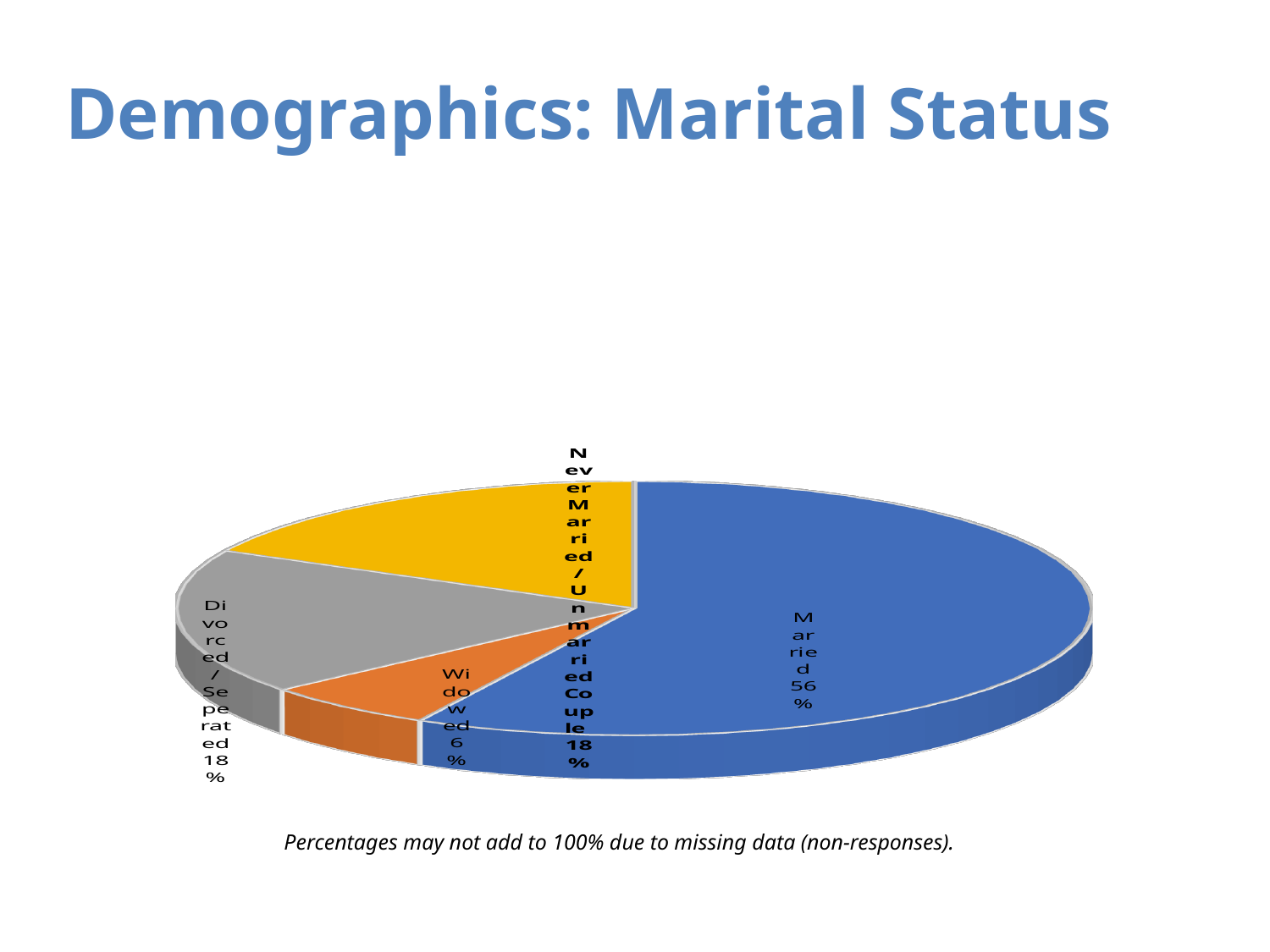
What percentage of respondents are Married? 56% What percentage of respondents are Divorced/Separated? 18% How many slices does the pie chart have? 4 What colour is the Married slice of the pie chart? Blue What is the title of the slide? Demographics: Marital Status Which marital status category has the smallest share of the pie? Widowed Which marital status category has the largest share of the pie? Married What percentage of respondents are Never Married/Unmarried Couple? 18% What kind of chart is shown on the slide? Pie chart Which is larger, the Married slice or the Divorced/Separated slice? Married What percentage of respondents are Widowed? 6% What is the difference in percentage points between the Married and Widowed slices? 50%